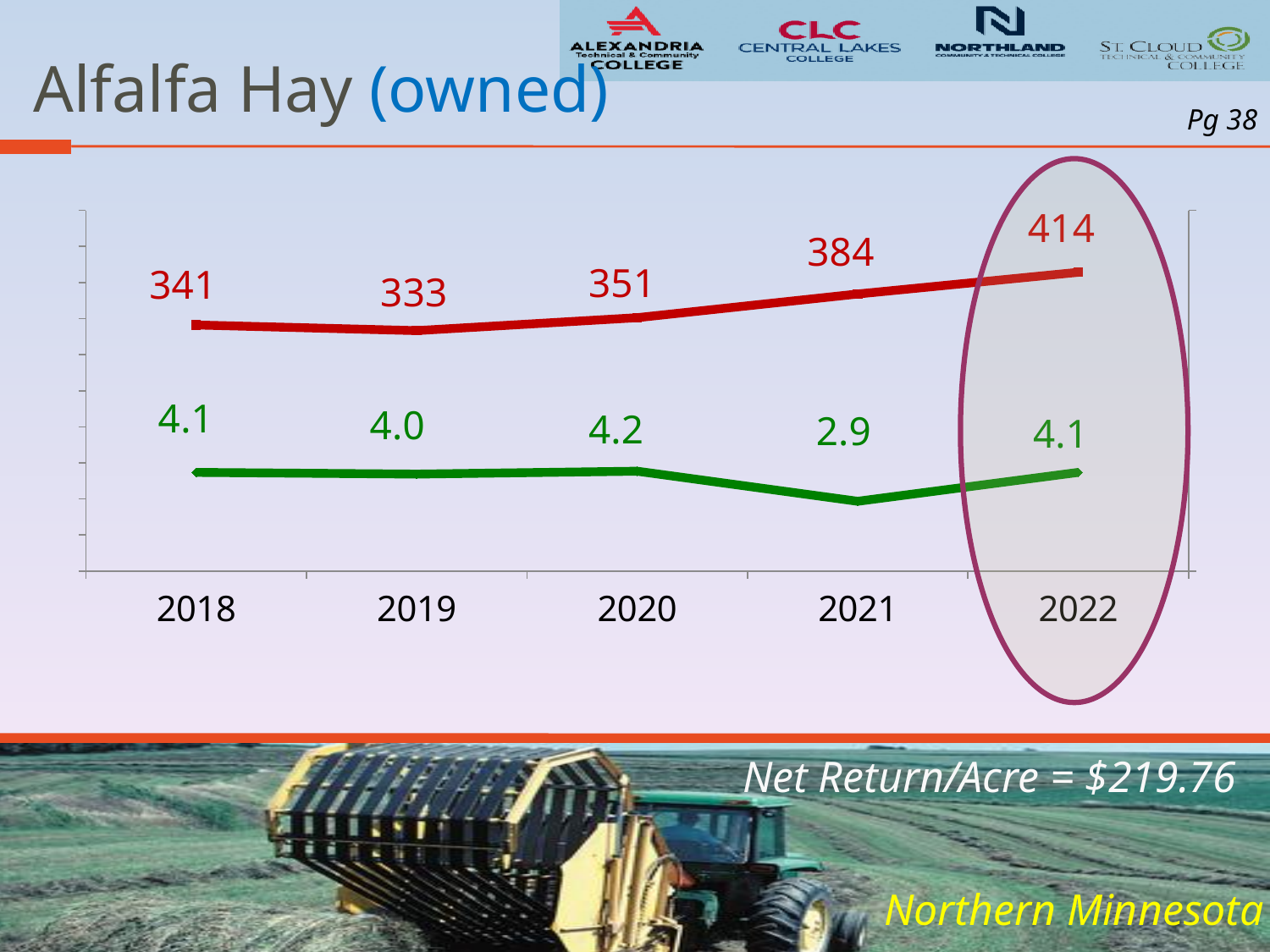
What kind of chart is shown on the slide? line chart What is the value of the green line for 2020? 4.2 In which year is the green line at its lowest value? 2021 What is the difference between the red line's values for 2022 and 2018? 73 In which year is the red line at its highest value? 2022 What is the value of the green line for 2021? 2.9 What is the value of the red line for 2022? 414 Which is larger, the red line's value for 2020 or for 2021? 2021 How many years are shown on the x axis? 5 What is the value of the red line for 2019? 333 In which year is the red line at its lowest value? 2019 Does the red line rise or fall from 2019 to 2022? rise